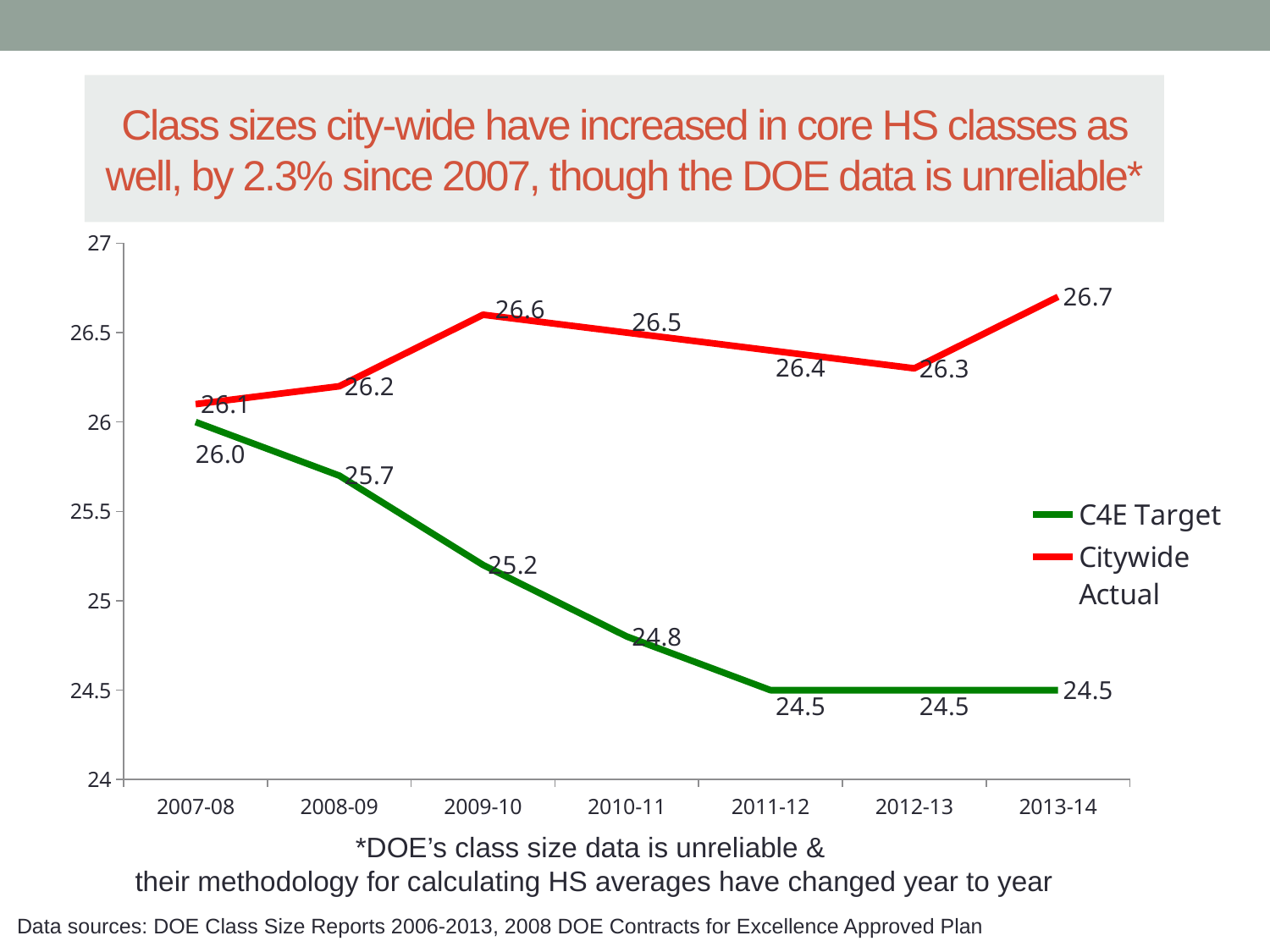
Which is larger in 2010-11, the Citywide Actual value or the C4E Target value? Citywide Actual What kind of chart is shown on the slide? Line chart Does the C4E Target series rise or fall from 2007-08 to 2011-12? Fall What is the difference between the Citywide Actual values for 2013-14 and 2007-08? 0.6 What is the C4E Target value for 2009-10? 25.2 What is the Citywide Actual value for 2007-08? 26.1 What is the Citywide Actual value for 2013-14? 26.7 In which year is the Citywide Actual value highest? 2013-14 How many series does the legend list? 2 In which year is the C4E Target value highest? 2007-08 How many years are shown on the x axis? 7 What is the difference between the Citywide Actual and C4E Target values in 2013-14? 2.2